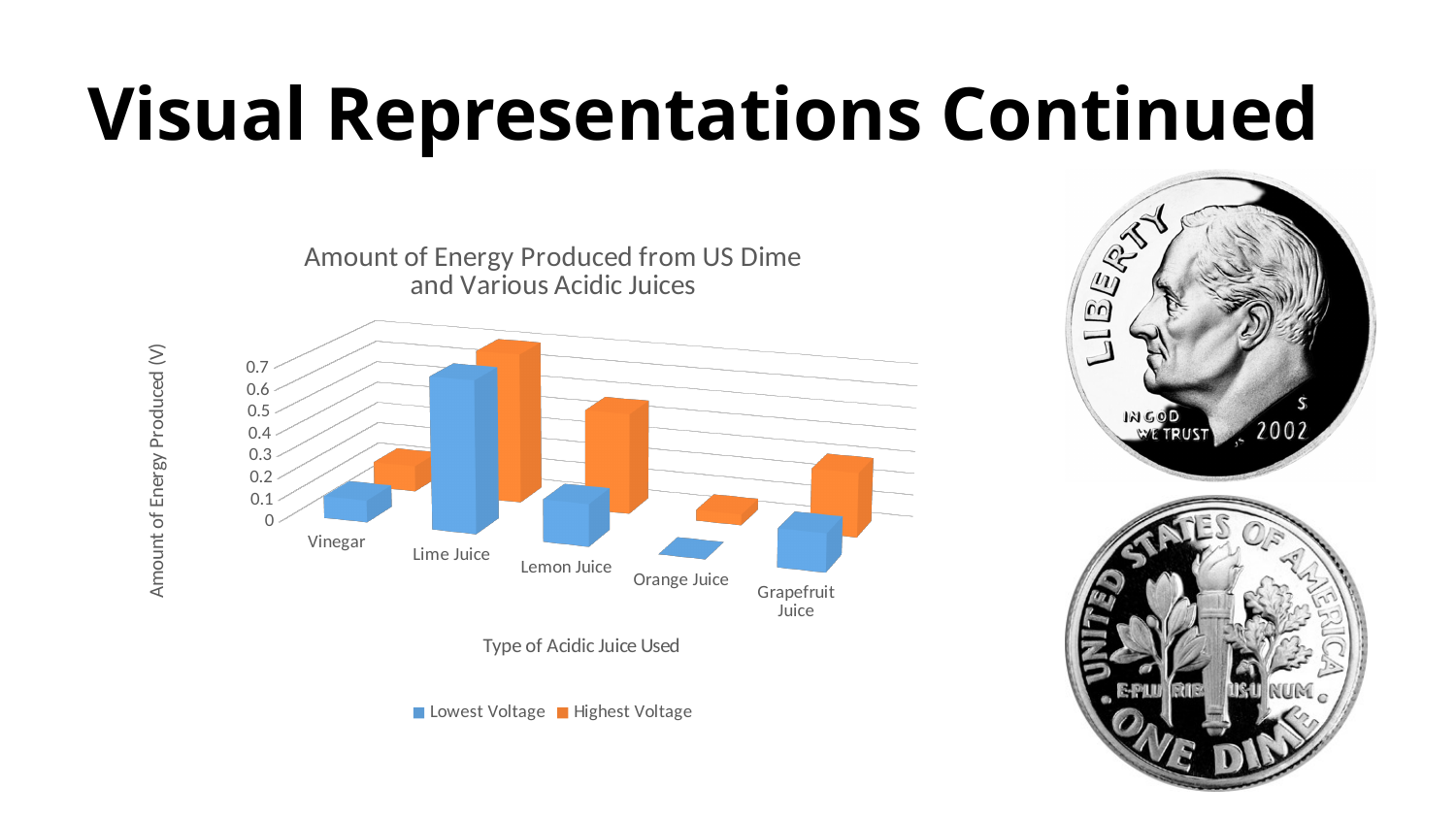
Is the Highest Voltage value for Grapefruit Juice greater or less than 0.5? less How many series does the chart's legend list? 2 Is the Lowest Voltage value for Vinegar greater or less than 0.3? less How many types of acidic juice are shown on the x axis of the chart? 5 What is the label on the chart's vertical axis? Amount of Energy Produced (V) Which has a larger Highest Voltage value, Lemon Juice or Grapefruit Juice? Lemon Juice Which type of acidic juice has the highest Highest Voltage value? Lime Juice Which type of acidic juice has the lowest Highest Voltage value? Orange Juice Is the Lowest Voltage value for Lime Juice greater or less than 0.3? greater What is the title of the chart? Amount of Energy Produced from US Dime and Various Acidic Juices What kind of chart is shown on the slide? bar chart Which type of acidic juice has the highest Lowest Voltage value? Lime Juice